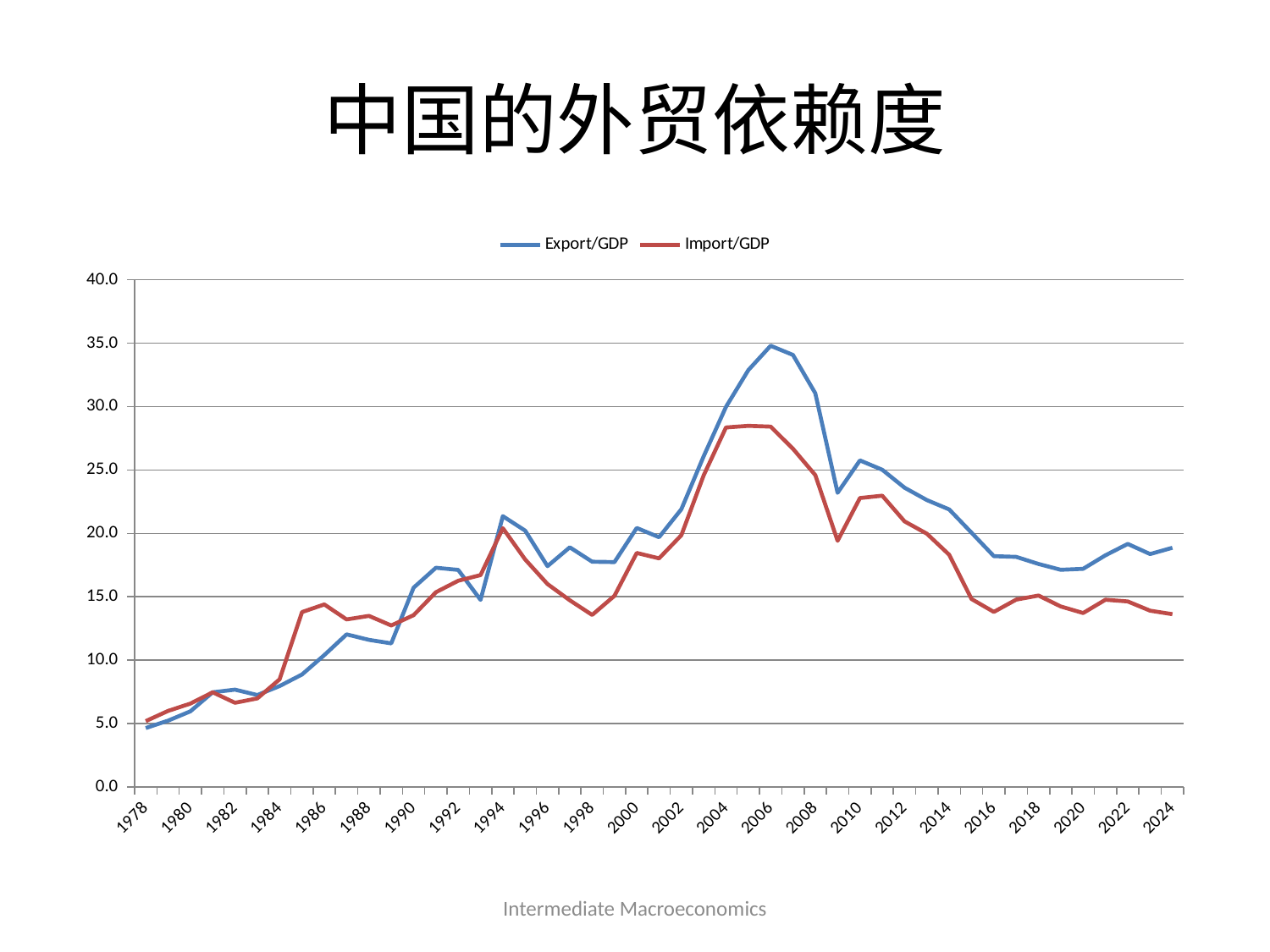
Is the value of Export/GDP in 2024 greater or less than 15.0? greater Is the value of Import/GDP in 2024 greater or less than 15.0? less In which year does the Export/GDP line reach its highest value? 2006 What kind of chart is shown on the slide? line chart What are the two series named in the legend? Export/GDP and Import/GDP In 2006, which series has the larger value, Export/GDP or Import/GDP? Export/GDP In 1986, which series has the larger value, Export/GDP or Import/GDP? Import/GDP Does the Export/GDP line generally rise or fall between 2006 and 2016? fall How many series does the legend list? 2 What is the title of the slide containing the chart? 中国的外贸依赖度 Is the value of Export/GDP in 2006 greater or less than 30.0? greater